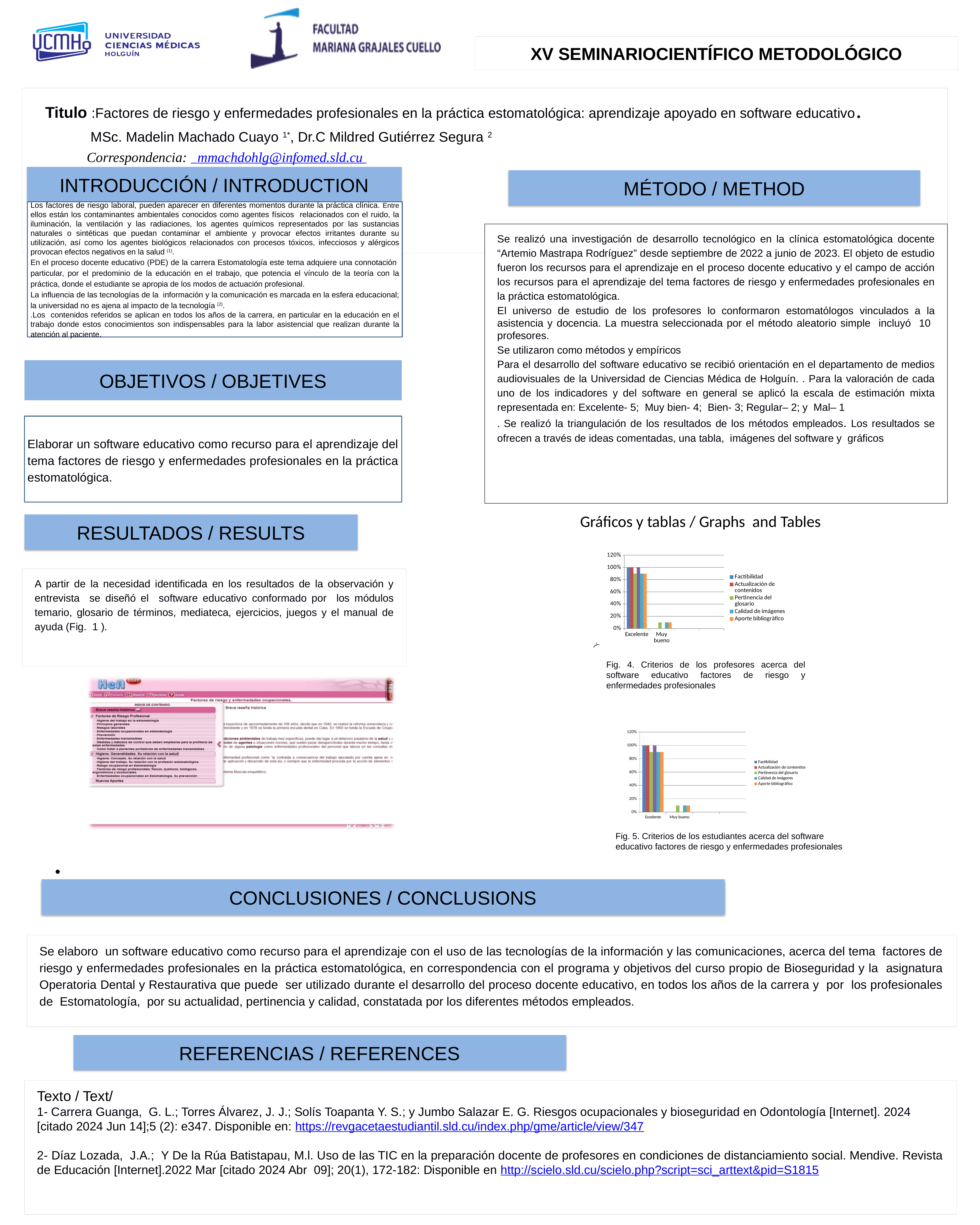
In Fig. 5 (Criterios de los estudiantes), is the value of Factibilidad for Excelente greater or less than 80%? greater In Fig. 4 (Criterios de los profesores), is the value of Aporte bibliográfico for Muy bueno greater or less than 20%? less In Fig. 5 (Criterios de los estudiantes), what kind of chart is shown? bar chart In Fig. 5 (Criterios de los estudiantes), what is the first entry in the legend? Factibilidad In Fig. 4 (Criterios de los profesores), does the value of Aporte bibliográfico rise or fall from Excelente to Muy bueno? fall In Fig. 4 (Criterios de los profesores), is the value of Calidad de imágenes for Excelente greater or less than 80%? greater In Fig. 4 (Criterios de los profesores), how many categories are shown on the x axis? 2 In Fig. 4 (Criterios de los profesores), what is the value of Factibilidad for Excelente? 100% In Fig. 5 (Criterios de los estudiantes), how many series does the legend list? 5 In Fig. 4 (Criterios de los profesores), what kind of chart is shown? bar chart In Fig. 4 (Criterios de los profesores), which is larger for Excelente: Factibilidad or Aporte bibliográfico? Factibilidad In Fig. 4 (Criterios de los profesores), how many series does the legend list? 5